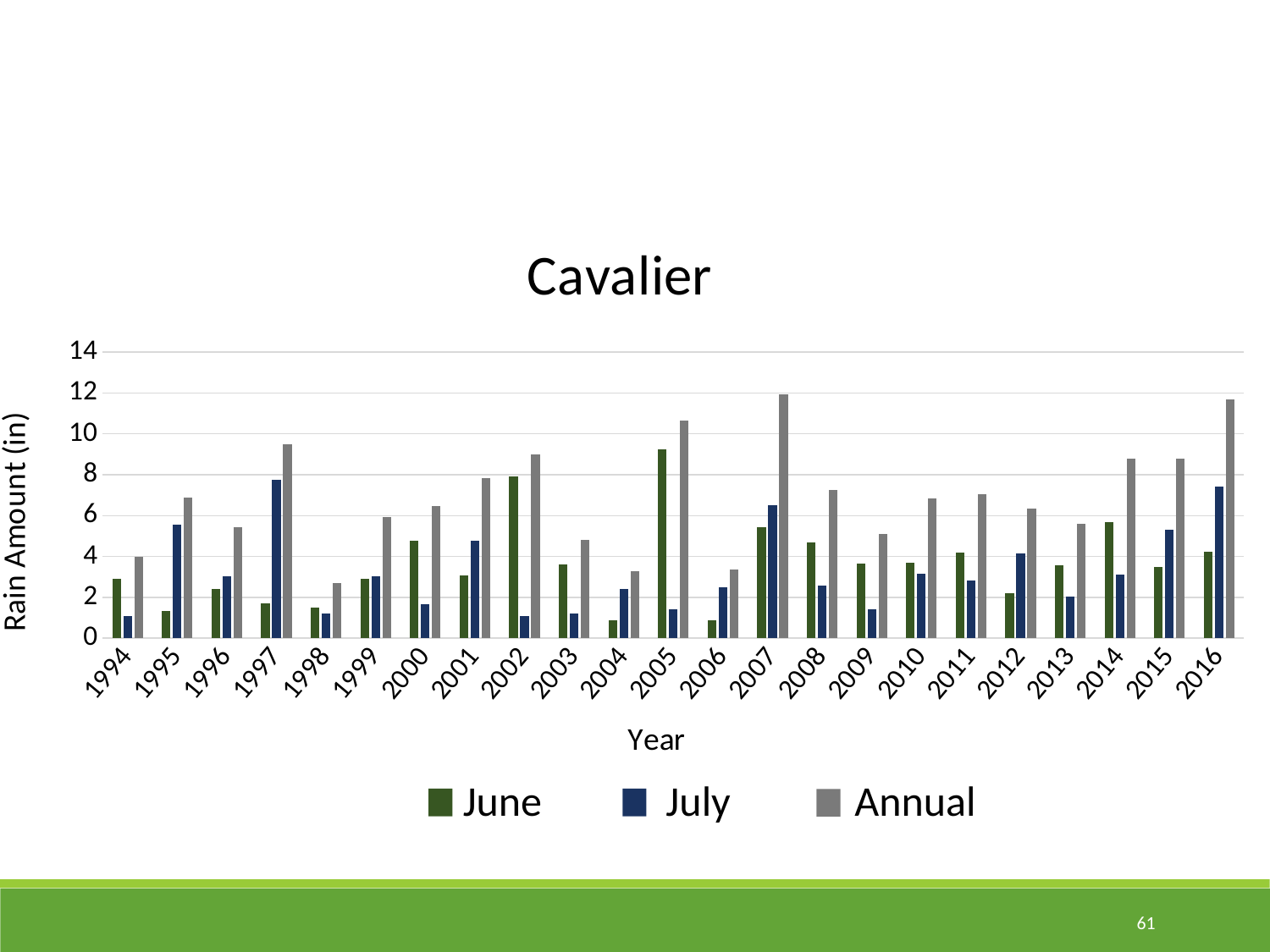
In which year is the Annual rain amount lowest? 1998 Which is larger, the Annual value for 2007 or the Annual value for 2009? 2007 Is the July value for 1997 greater or less than 6? greater Which is larger, the July value for 1995 or the July value for 1996? 1995 How many series does the legend list? 3 Is the June value for 2005 greater or less than 8? greater In which year is the June rain amount highest? 2005 Is the Annual value for 1998 greater or less than 4? less What is the title of the chart? Cavalier How many years are shown on the x axis? 23 What kind of chart is shown on the slide? bar chart What is the label of the y axis? Rain Amount (in)